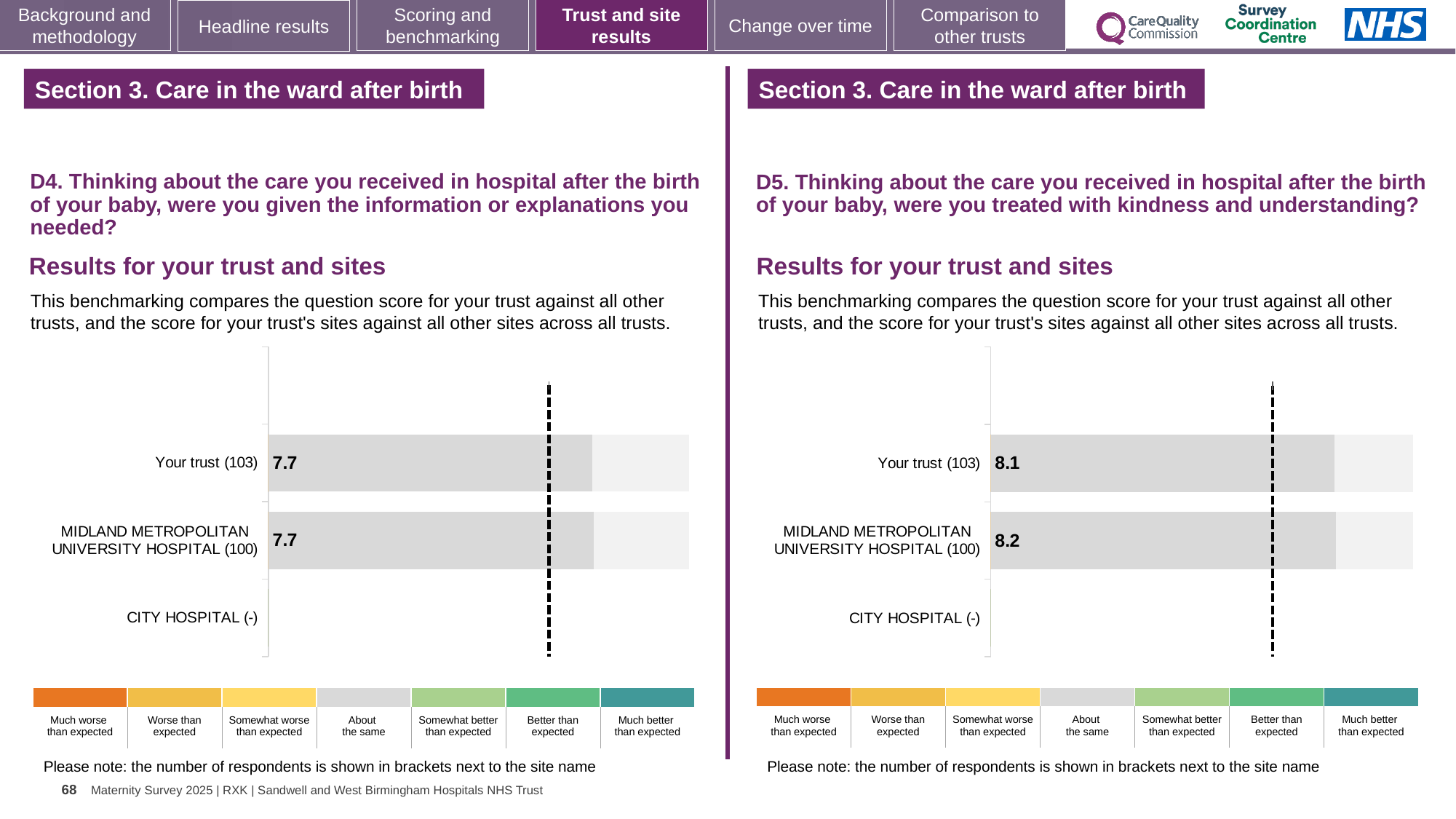
How many site/trust rows are listed in the D4 chart on the left? 3 In the D5 chart on the right, what is the score for MIDLAND METROPOLITAN UNIVERSITY HOSPITAL (100)? 8.2 What kind of chart is used for the D5 results on the right? bar chart In the D4 chart on the left, which row has no score shown? CITY HOSPITAL (-) In the D4 chart on the left, what is the score for Your trust (103)? 7.7 In the D4 chart on the left, is the score for Your trust (103) higher than, lower than, or equal to the score for MIDLAND METROPOLITAN UNIVERSITY HOSPITAL (100)? equal In the D5 chart on the right, which has the higher score: Your trust (103) or MIDLAND METROPOLITAN UNIVERSITY HOSPITAL (100)? MIDLAND METROPOLITAN UNIVERSITY HOSPITAL (100) In the D5 chart on the right, how many respondents are shown in brackets for Your trust? 103 How many rating categories does the colour key below the D5 chart on the right list? 7 In the D5 chart on the right, what is the score for Your trust (103)? 8.1 In the D5 chart on the right, what is the difference between the scores for MIDLAND METROPOLITAN UNIVERSITY HOSPITAL (100) and Your trust (103)? 0.1 In the D4 chart on the left, what is the score for MIDLAND METROPOLITAN UNIVERSITY HOSPITAL (100)? 7.7